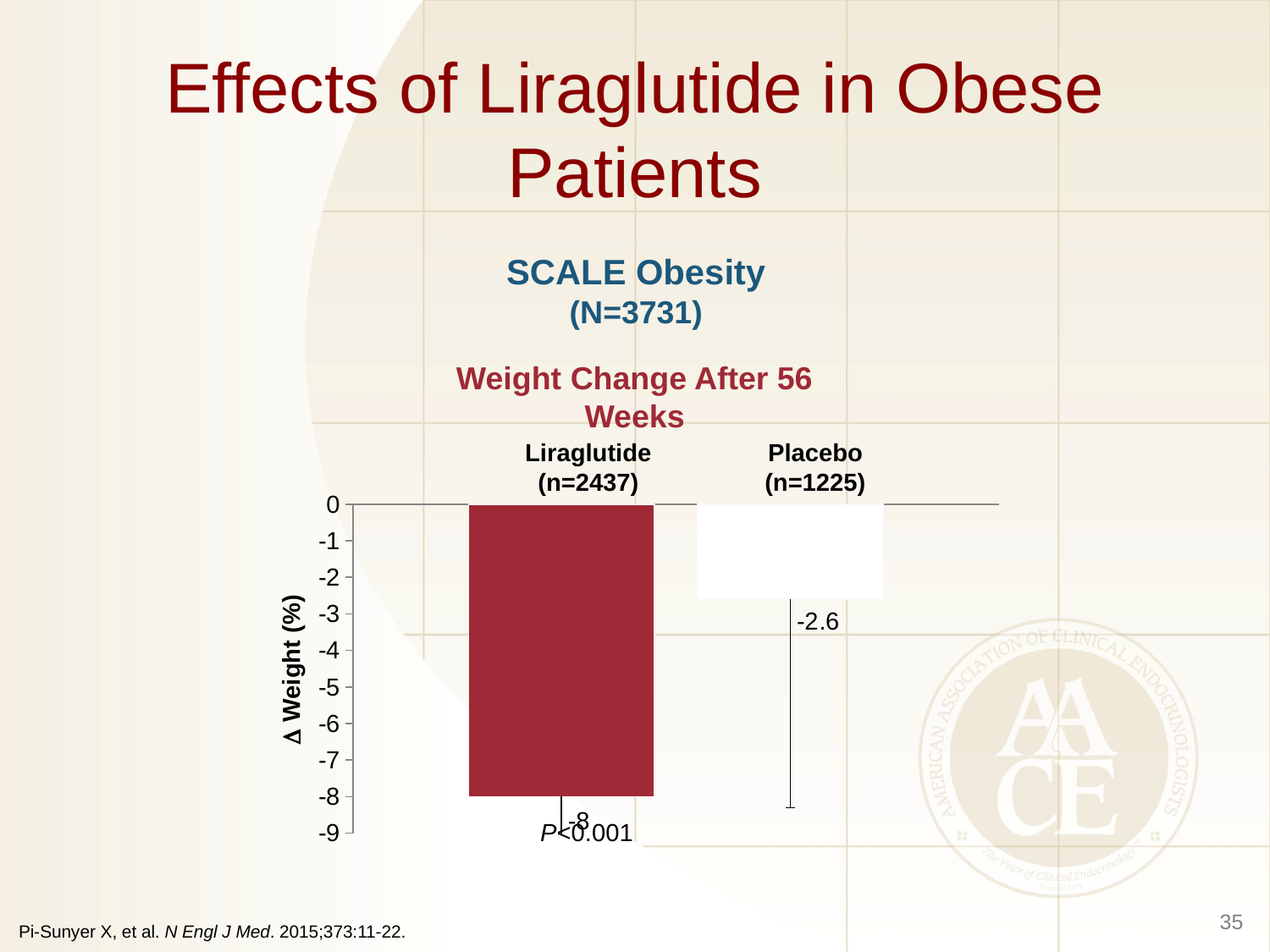
What is the label of the y-axis? Δ Weight (%) What is the difference between the Liraglutide and Placebo weight change values? 5.4 What is the weight change value shown for Placebo? -2.6 Which group has the highest (least negative) weight change value? Placebo What is the weight change value shown for Liraglutide? -8 Which group has the lowest (most negative) weight change value? Liraglutide Is the weight change value for Placebo greater or less than -5? greater What type of chart is shown on the slide? Bar chart What is the sample size (n) shown for the Placebo group? n=1225 What is the title of the chart? Weight Change After 56 Weeks How many groups (bars) are plotted in the chart? 2 Which group shows the larger weight reduction, Liraglutide or Placebo? Liraglutide